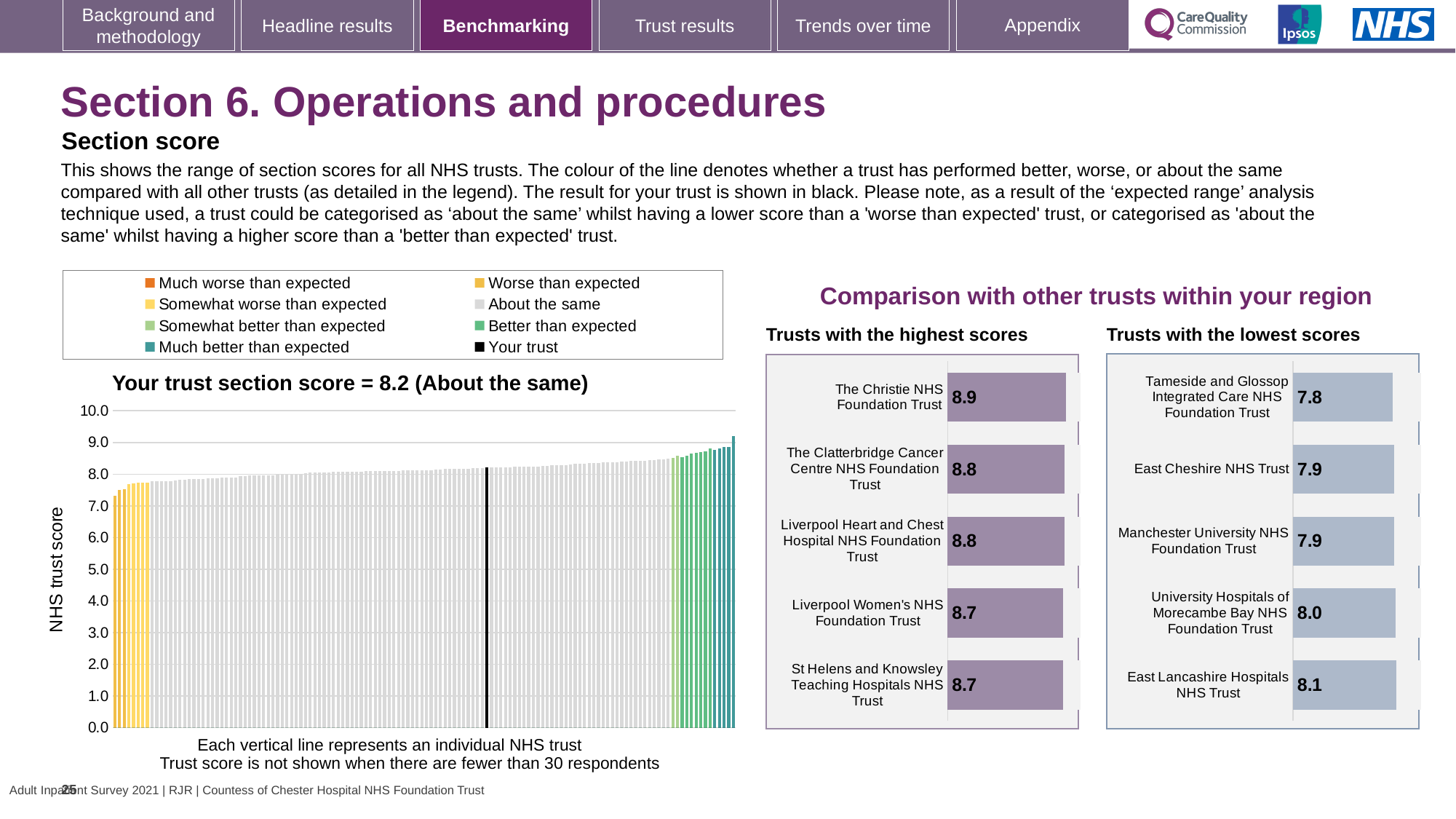
In the 'Your trust section score' chart, what is the label on the vertical axis? NHS trust score In the 'Trusts with the lowest scores' chart, what is the score for Tameside and Glossop Integrated Care NHS Foundation Trust? 7.8 In the 'Trusts with the highest scores' chart, what is the score for The Christie NHS Foundation Trust? 8.9 In the 'Trusts with the highest scores' chart, what is the difference between the scores of The Christie NHS Foundation Trust and Liverpool Women's NHS Foundation Trust? 0.2 In the 'Your trust section score' chart, is the value of the lowest bar greater or less than 8.0? less In the 'Trusts with the highest scores' chart, which trust has the highest score? The Christie NHS Foundation Trust How many entries does the legend above the 'Your trust section score' chart list? 8 In the 'Your trust section score' chart, what is the section score for your trust? 8.2 What kind of chart is the 'Your trust section score' chart? bar chart In the 'Trusts with the highest scores' chart, how many trusts are shown? 5 In the 'Trusts with the lowest scores' chart, which trust has the lowest score? Tameside and Glossop Integrated Care NHS Foundation Trust In the 'Trusts with the lowest scores' chart, what is the difference between the scores of East Lancashire Hospitals NHS Trust and Tameside and Glossop Integrated Care NHS Foundation Trust? 0.3